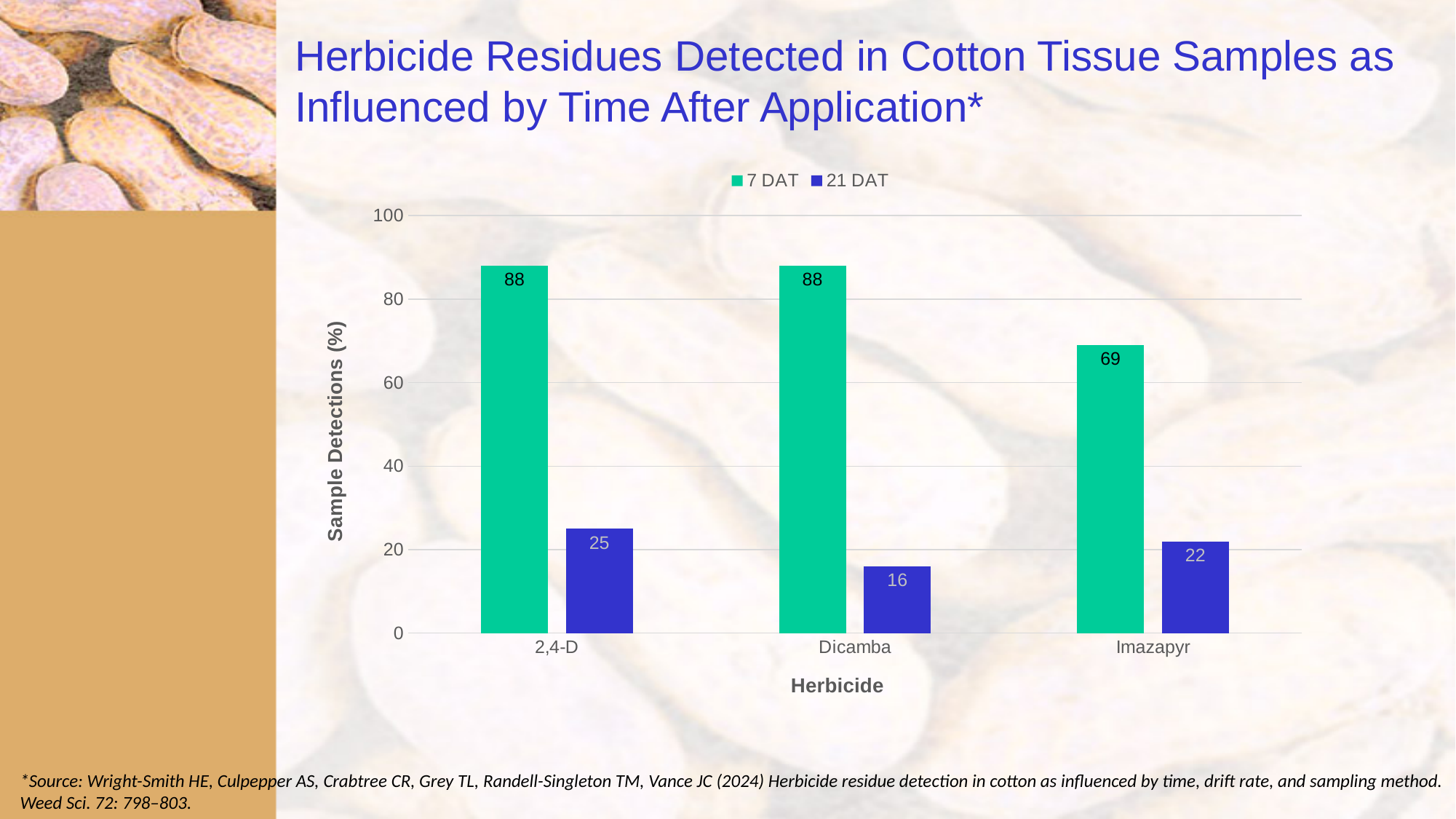
Which is larger for Imazapyr, the 7 DAT value or the 21 DAT value? 7 DAT Which herbicide has the lowest 7 DAT value? Imazapyr How many series does the legend list? 2 What kind of chart is shown on the slide? Bar chart What is the 7 DAT value for 2,4-D? 88 What is the 21 DAT value for 2,4-D? 25 What is the 21 DAT value for Dicamba? 16 How many herbicides are shown on the x axis? 3 What is the difference between the 7 DAT and 21 DAT values for Dicamba? 72 What is the label of the y axis? Sample Detections (%) Which herbicide has the highest 21 DAT value? 2,4-D What is the 7 DAT value for Imazapyr? 69